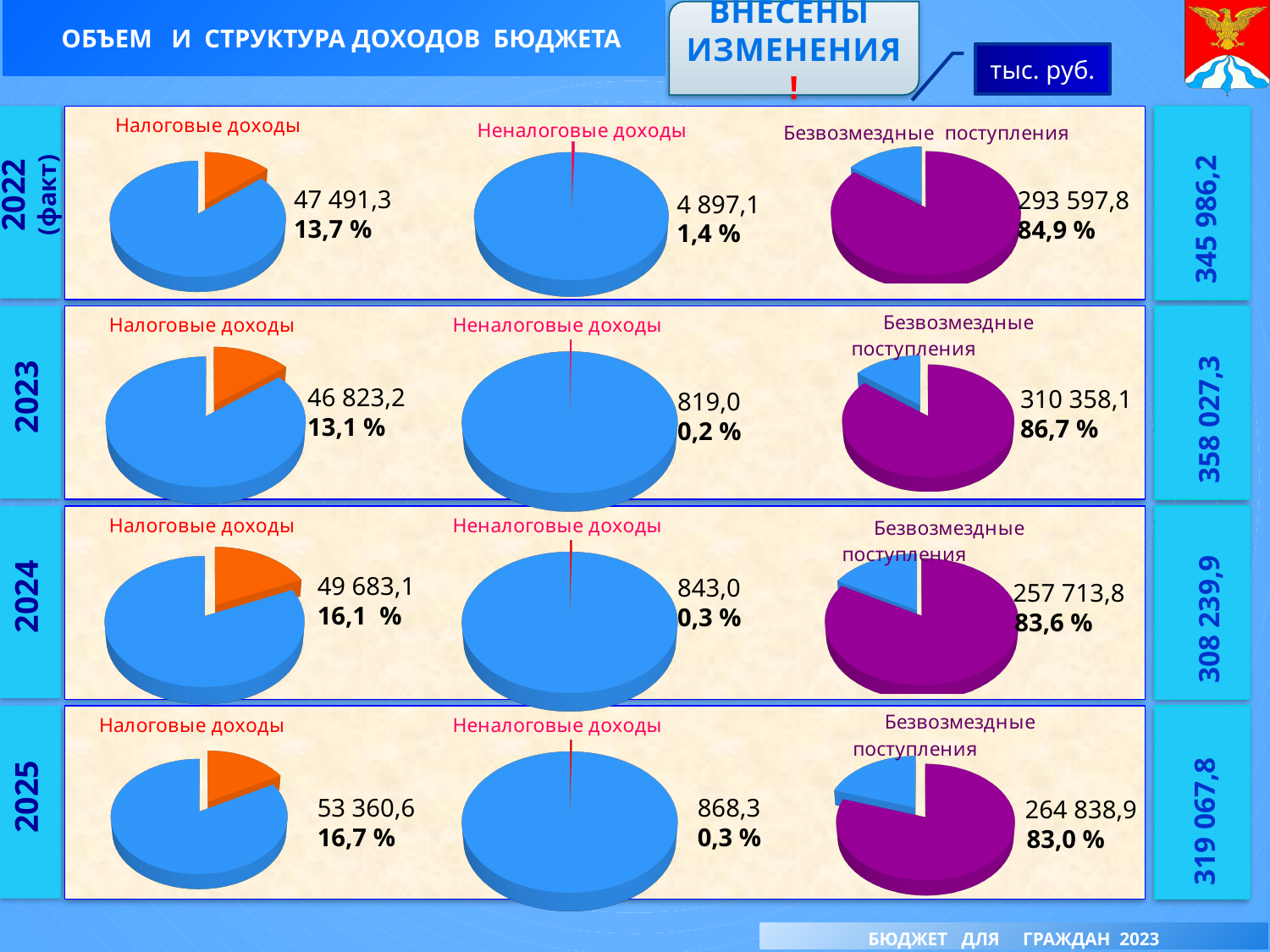
In the 2022 (факт) row, what value is shown for the Налоговые доходы pie chart? 47 491,3 In the 2025 row, what value is shown for the Налоговые доходы pie chart? 53 360,6 In the 2022 (факт) row, what share of the pie does Безвозмездные поступления represent? 84,9 % Which year's Неналоговые доходы pie chart shows the lowest value? 2023 In the 2023 row, what share is shown for Налоговые доходы? 13,1 % In the 2023 row, what value is shown for the Неналоговые доходы pie chart? 819,0 In the 2025 row, what share is shown for Неналоговые доходы? 0,3 % Which year's Налоговые доходы pie chart shows the highest value? 2025 What type of charts are shown on the slide? Pie charts In the 2024 row, what value is shown for the Безвозмездные поступления pie chart? 257 713,8 Is the Налоговые доходы value for 2024 larger or smaller than the Налоговые доходы value for 2023? larger What is the difference between the Налоговые доходы values for 2025 and 2024? 3 677,5